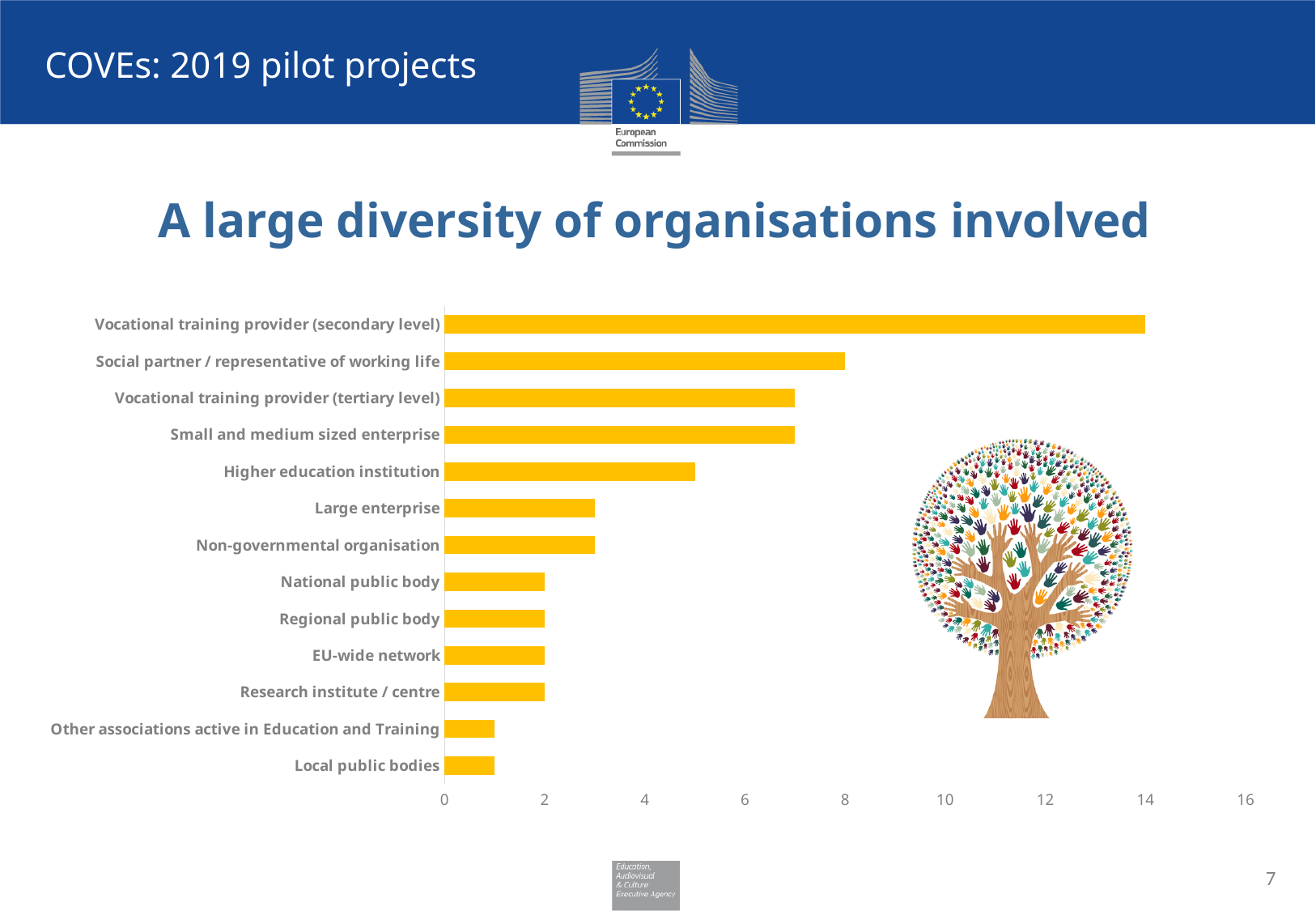
What is the value for National public body? 2 Which category has the highest value in the chart? Vocational training provider (secondary level) Is the value for Higher education institution greater or less than 4? greater How many categories are plotted in the chart? 13 What kind of chart is shown on the slide? bar chart Is the value for Large enterprise greater or less than 4? less Which is larger, the value for Small and medium sized enterprise or the value for Higher education institution? Small and medium sized enterprise Is the value for Local public bodies greater or less than 2? less What is the value for Vocational training provider (secondary level)? 14 What is the title shown above the chart? A large diversity of organisations involved What is the value for Social partner / representative of working life? 8 What is the difference between the values for Vocational training provider (secondary level) and Social partner / representative of working life? 6